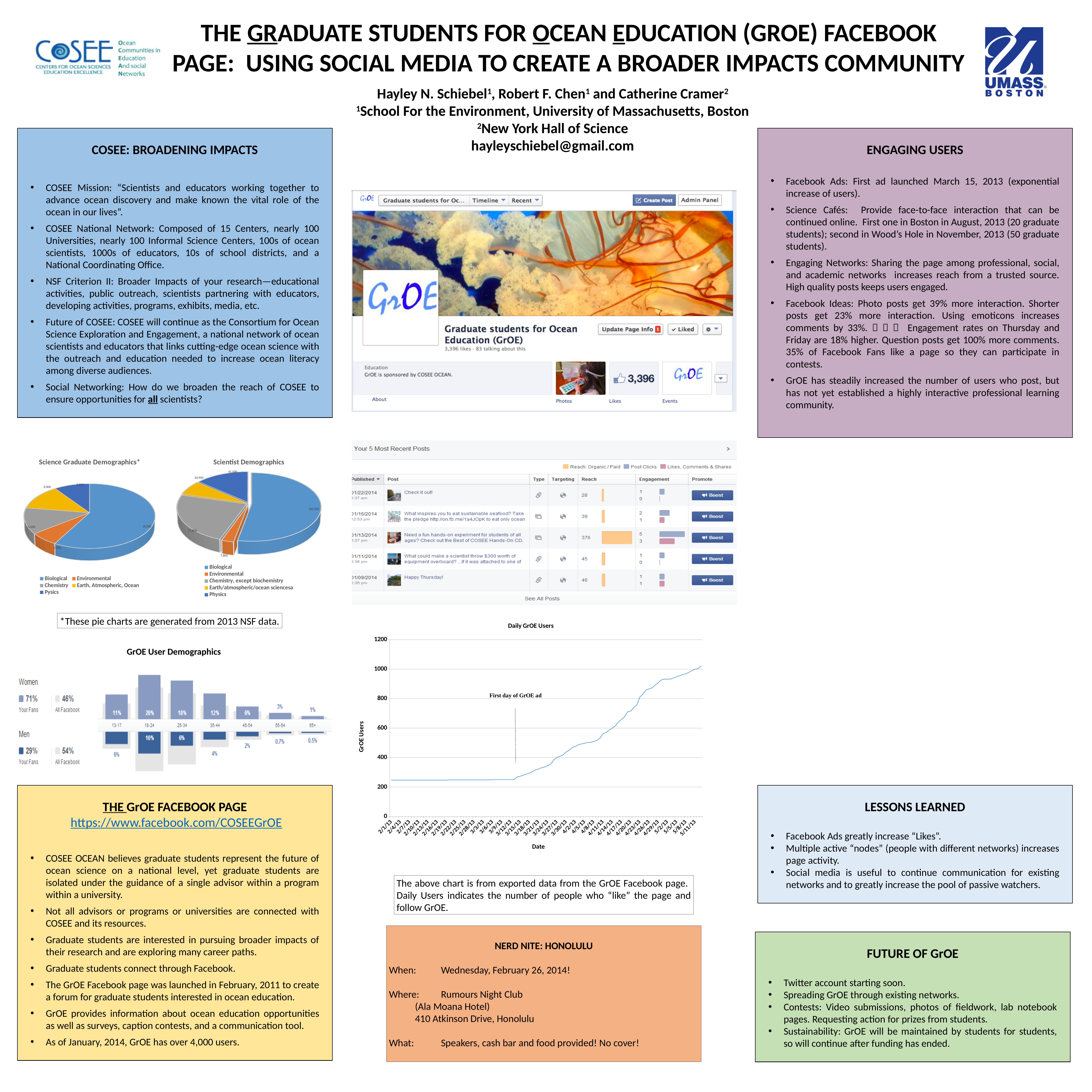
In the "Daily GrOE Users" chart, is the value on 5/11/13 greater or less than 800? greater In the "GrOE User Demographics" chart, which age group has the highest percentage of women fans? 18-24 What kind of chart is the "Scientist Demographics" chart? pie chart In the "Scientist Demographics" pie chart, which category has the largest slice? Biological In the "GrOE User Demographics" chart, what percentage of Your Fans are women? 71% In the "Daily GrOE Users" chart, is the value on 2/1/13 greater or less than 400? less In the "Daily GrOE Users" chart, what event is marked by the annotation on the chart? First day of GrOE ad In the "GrOE User Demographics" chart, what is the difference between the Your Fans percentages for women and men? 42% How many categories does the legend of the "Science Graduate Demographics*" pie chart list? 5 What is the highest tick value on the y axis of the "Daily GrOE Users" chart? 1200 In the "Daily GrOE Users" chart, do the values rise or fall from 2/1/13 to 5/11/13? rise What kind of chart is the "Daily GrOE Users" chart? line chart